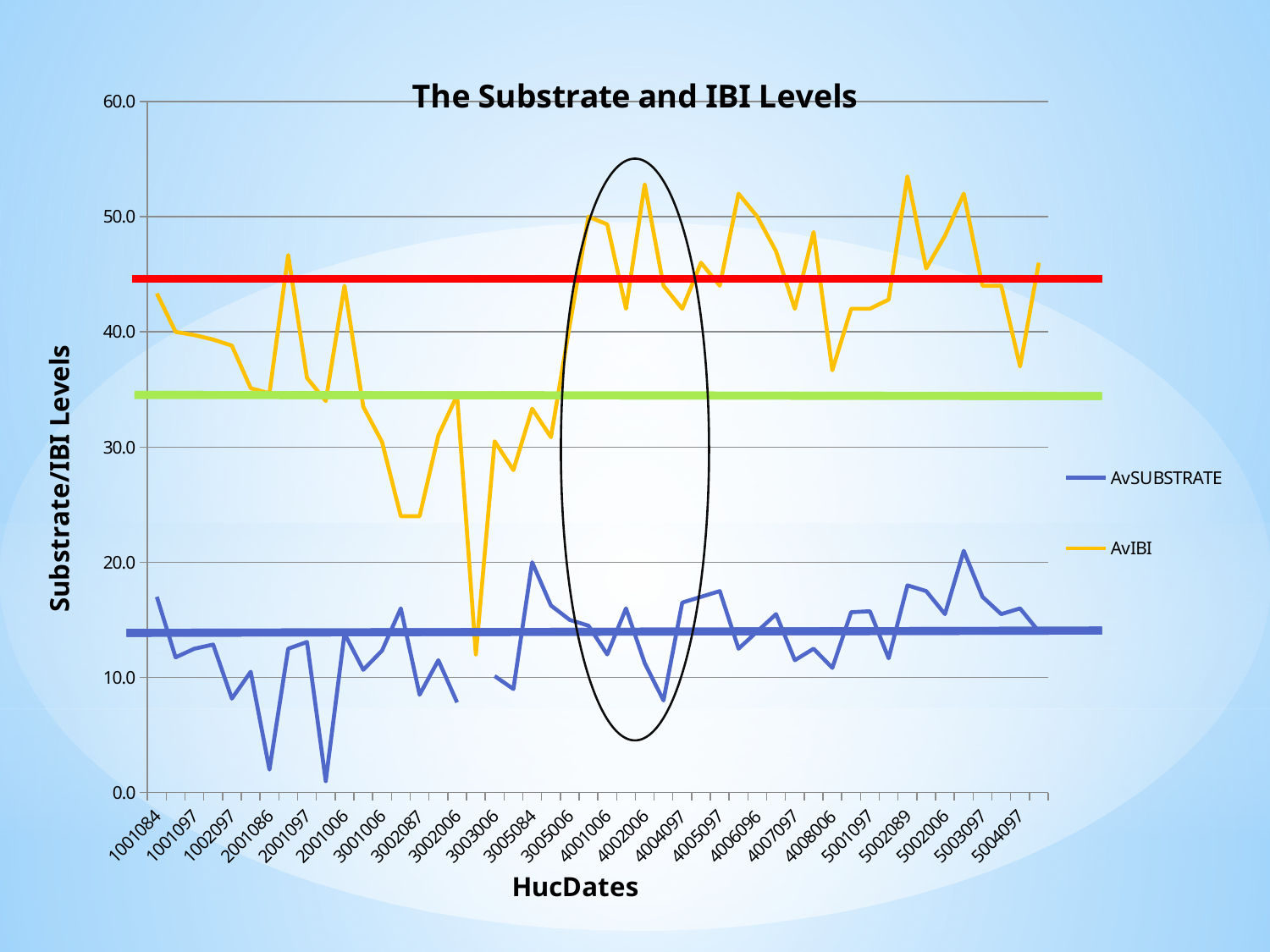
What is the label of the x axis? HucDates Is the AvIBI value at 5002089 greater or less than 50? greater What kind of chart is shown on the slide? line chart At 1001084, which series has the larger value, AvSUBSTRATE or AvIBI? AvIBI Is the AvIBI value at 1001084 greater or less than 40? greater Is the AvSUBSTRATE value at 3002006 greater or less than 10? less Which series is plotted consistently above the other across the chart? AvIBI What is the title of the chart? The Substrate and IBI Levels How many series does the legend list? 2